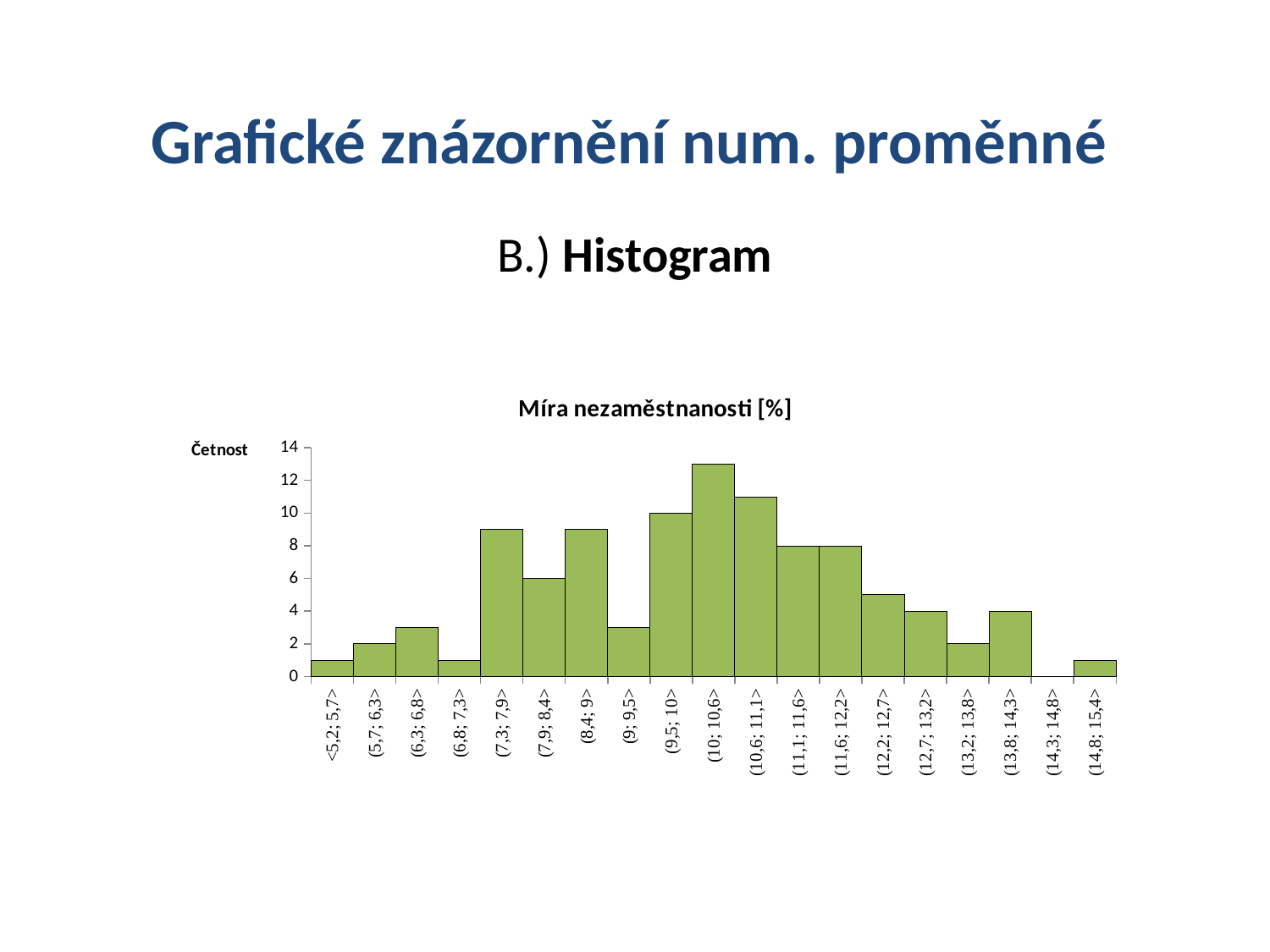
What is the frequency for the interval (11,1; 11,6>? 8 What is the frequency for the interval (9,5; 10>? 10 Which interval has the lowest frequency? (14,3; 14,8> Is the frequency for the interval (10; 10,6> greater or less than 12? greater Is the frequency for the interval (12,2; 12,7> greater or less than 4? greater How many intervals (bars) are shown on the x axis? 19 Which interval has the larger frequency, (7,9; 8,4> or (9,5; 10>? (9,5; 10> What kind of chart is shown on the slide? bar chart (histogram) What is the label of the vertical axis? Četnost What is the title of the chart? Míra nezaměstnanosti [%] What is the frequency for the interval (7,9; 8,4>? 6 Which interval has the highest frequency? (10; 10,6>